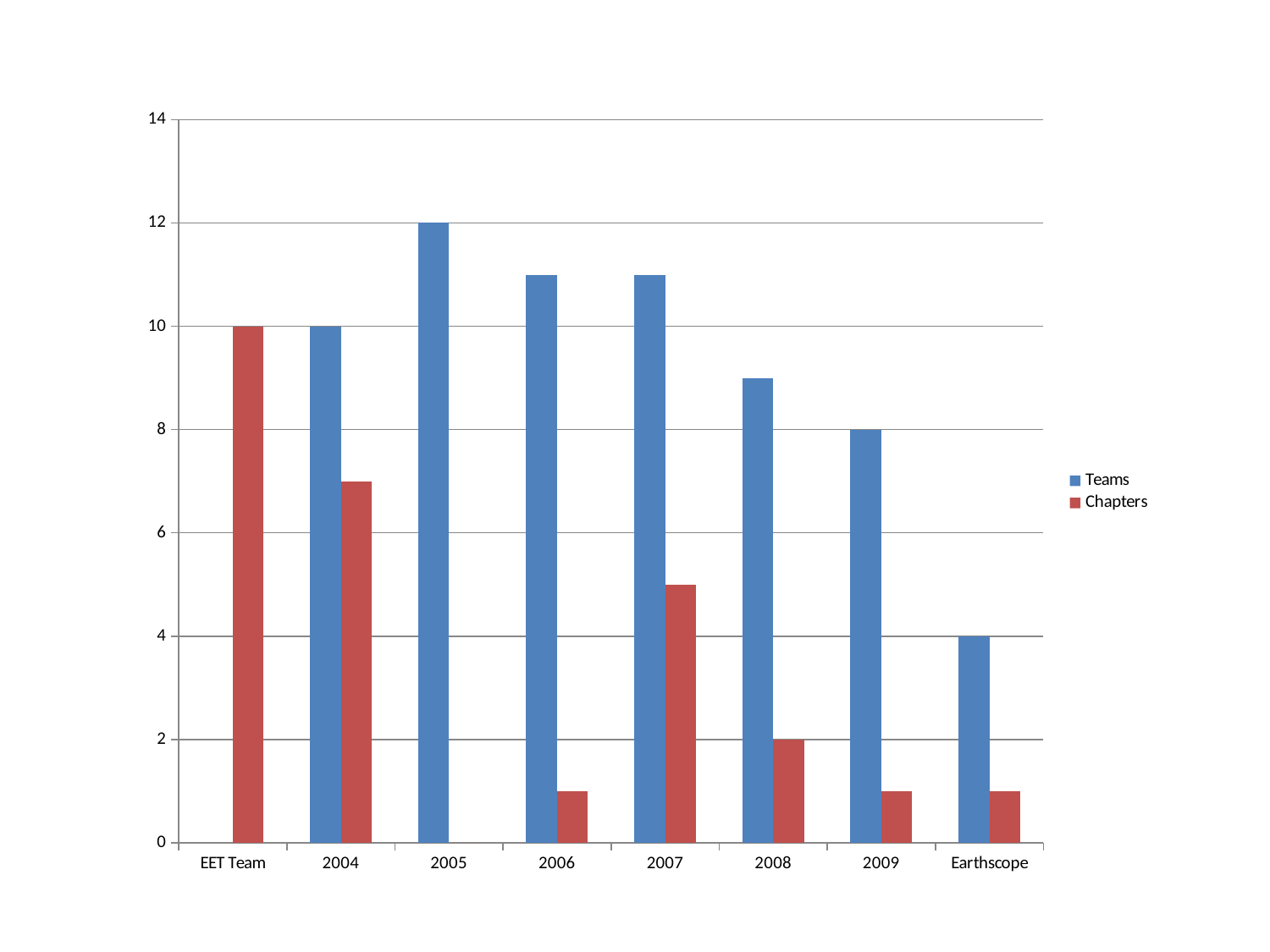
Is the Chapters value for 2007 greater or less than 4? greater How many series does the legend list? 2 What is the Teams value for 2009? 8 Is the Teams value for 2006 greater or less than 10? greater What is the Teams value for Earthscope? 4 How many categories are shown on the x axis? 8 Which category has the highest Teams value? 2005 Which category has the lowest Teams value? Earthscope What is the Chapters value for EET Team? 10 What is the Teams value for 2005? 12 Which category has the highest Chapters value? EET Team What is the difference between the Teams value for 2005 and the Teams value for 2009? 4